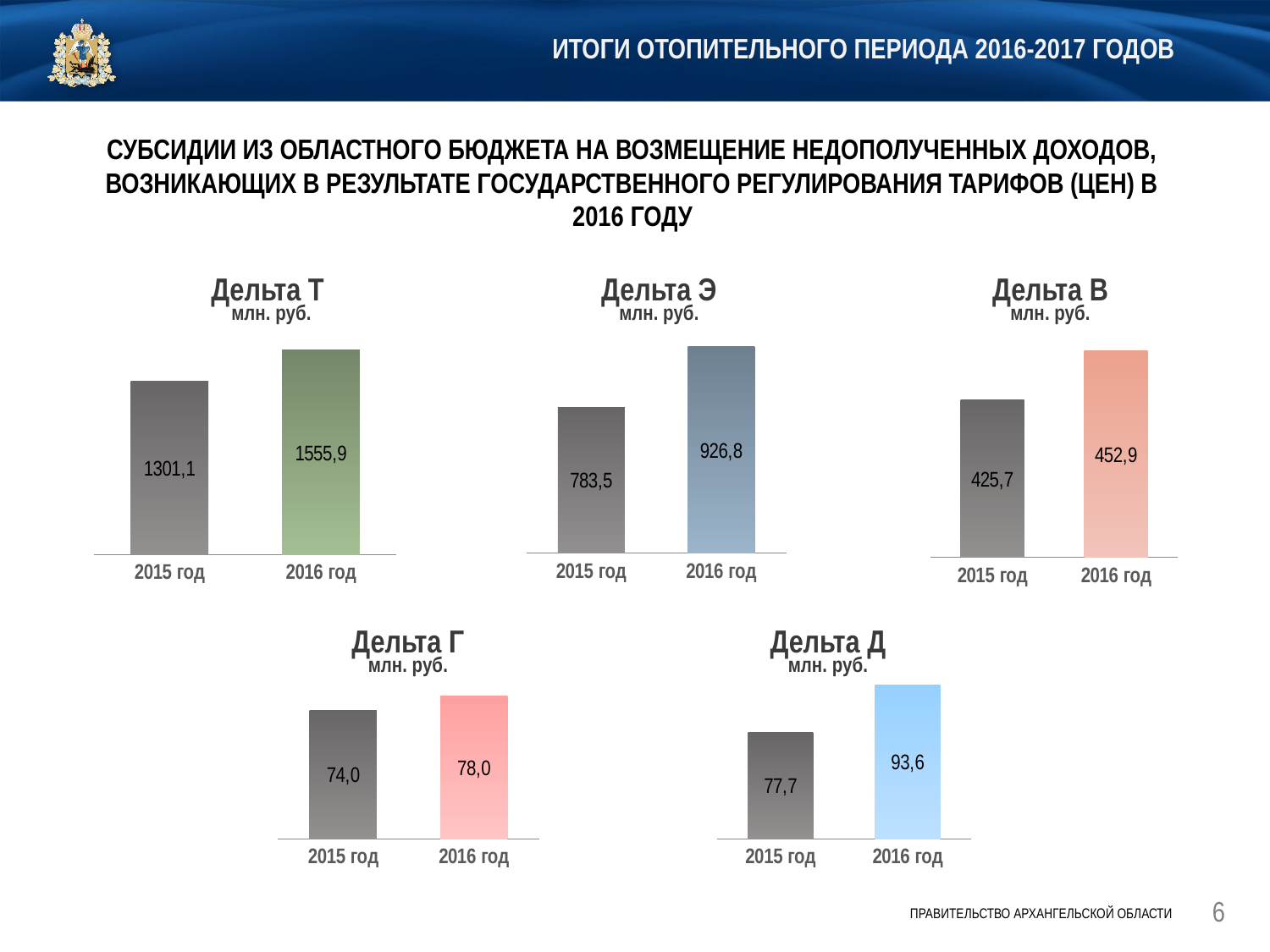
What kind of chart is the one titled "Дельта Э"? bar chart In the chart titled "Дельта Э", what is the value for 2015 год? 783,5 In the chart titled "Дельта Т", do the values rise or fall from 2015 год to 2016 год? rise In the chart titled "Дельта Э", by how much does the 2016 год value exceed the 2015 год value? 143,3 In the chart titled "Дельта Т", what is the difference between the 2016 год and 2015 год values? 254,8 In the chart titled "Дельта Г", what is the difference between the 2016 год and 2015 год values? 4,0 In the chart titled "Дельта В", what is the value for 2016 год? 452,9 In the chart titled "Дельта Д", what is the value for 2015 год? 77,7 How many categories are shown in the chart titled "Дельта Г"? 2 In the chart titled "Дельта В", which category has the lowest value? 2015 год In the chart titled "Дельта Д", which year has the higher value, 2015 год or 2016 год? 2016 год In the chart titled "Дельта Т", what is the value for 2016 год? 1555,9